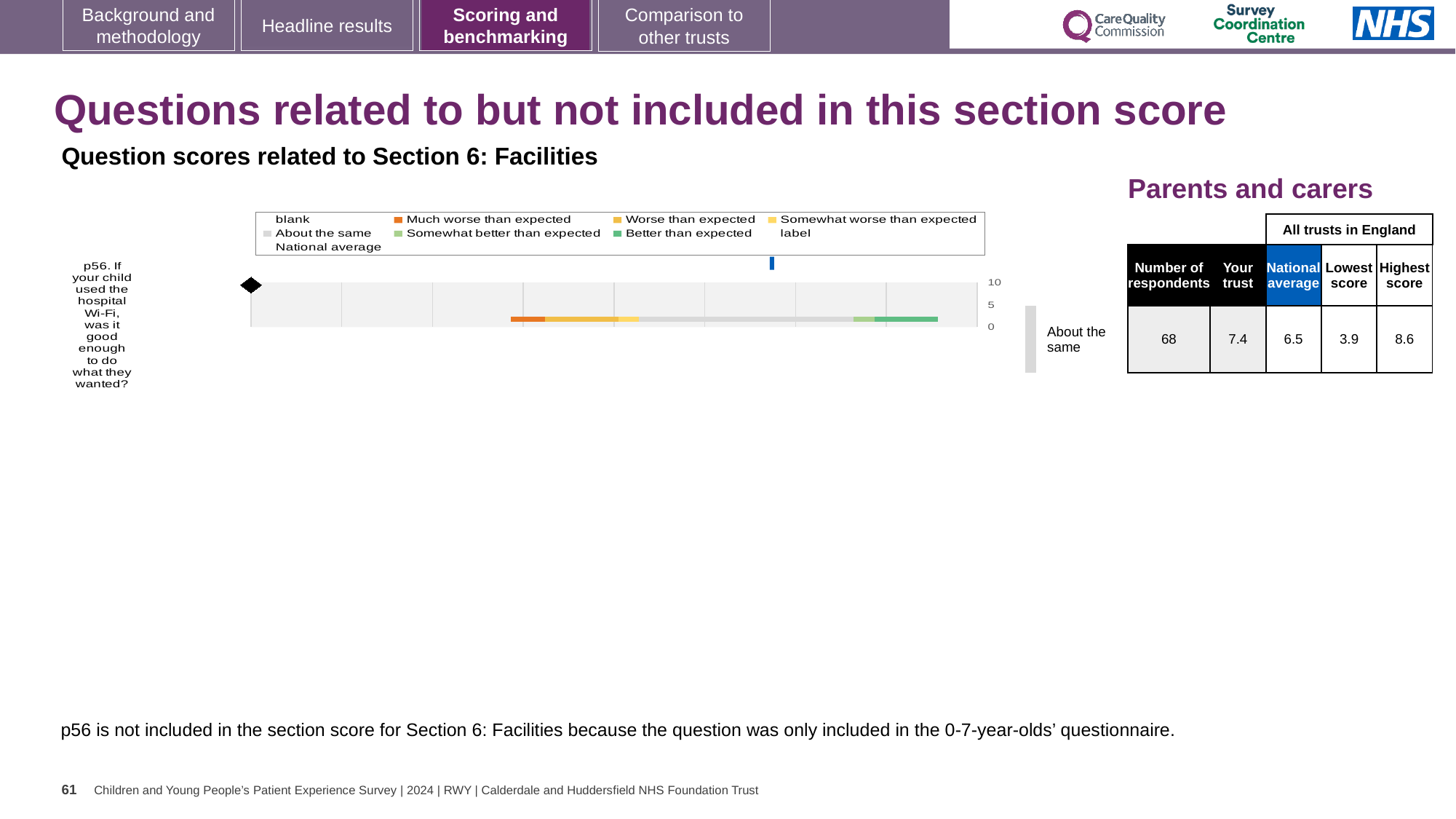
What is the national average score for p56 shown in the table? 6.5 Is the 'Your trust' score for p56 greater or less than 5? greater Which is larger for p56, the 'Your trust' score or the national average? Your trust What kind of chart is used to show the p56 question score? bar chart What is the highest score among all trusts in England for p56? 8.6 What colour represents 'Much worse than expected' in the chart legend? orange What is the 'Your trust' score for p56 in the table next to the chart? 7.4 How many respondents answered p56? 68 What is the difference between the 'Your trust' score and the national average for p56? 0.9 What is the difference between the highest and lowest trust scores for p56? 4.7 What is the lowest score among all trusts in England for p56? 3.9 What benchmark category label is shown for the trust's p56 result? About the same